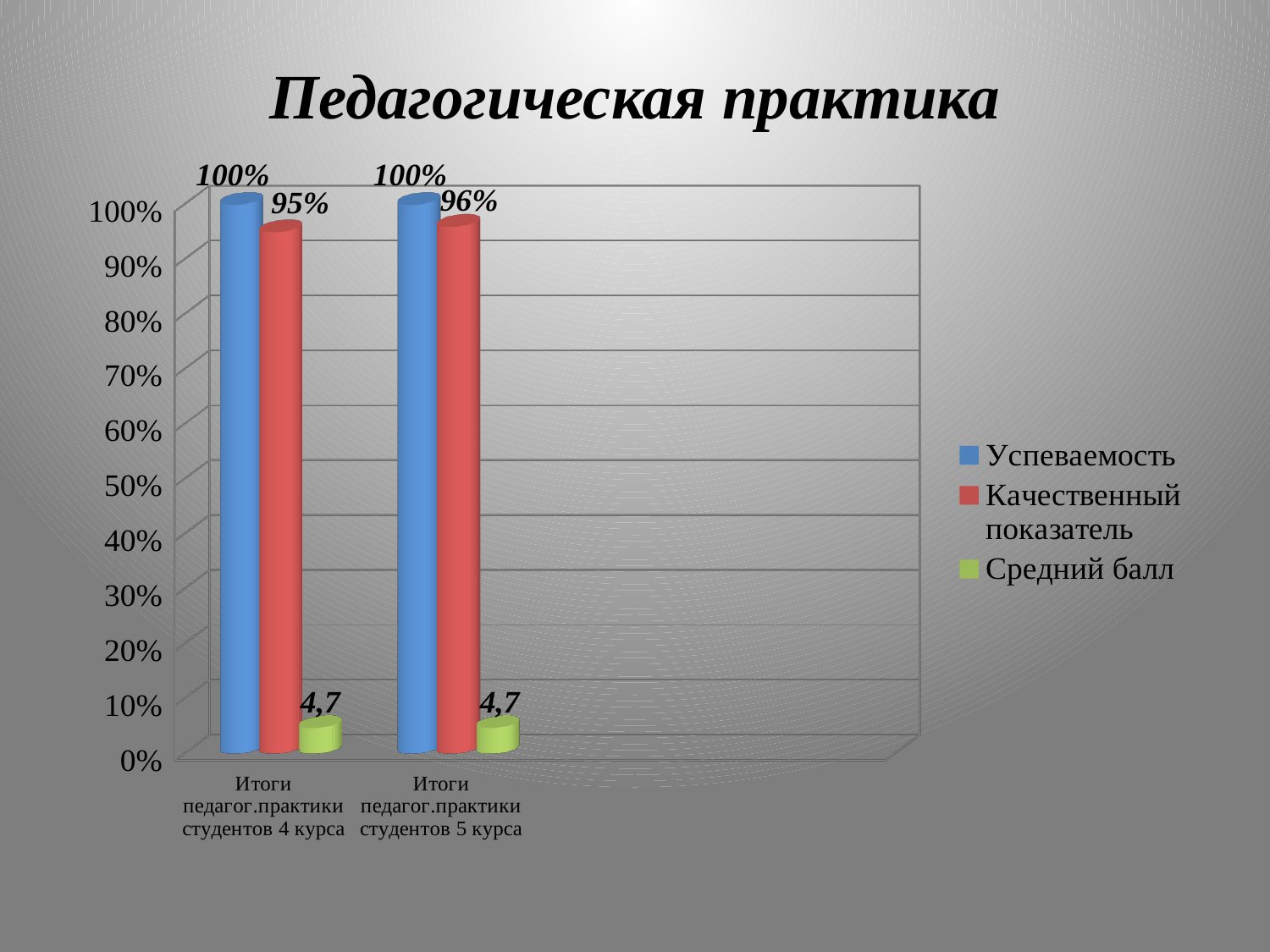
What is the value of Успеваемость for Итоги педагог.практики студентов 5 курса? 100% What is the value of Качественный показатель for Итоги педагог.практики студентов 4 курса? 95% How many categories are shown on the x axis? 2 How many series does the legend list? 3 What is the title of the slide? Педагогическая практика What is the value of Средний балл for Итоги педагог.практики студентов 4 курса? 4,7 What is the value of Качественный показатель for Итоги педагог.практики студентов 5 курса? 96% What kind of chart is shown on the slide? Bar chart Which colour represents the Средний балл series? Green What is the difference between Успеваемость and Качественный показатель for Итоги педагог.практики студентов 4 курса? 5% Which category has the higher Качественный показатель value? Итоги педагог.практики студентов 5 курса What is the difference between the Качественный показатель values for students of 5 курса and 4 курса? 1%